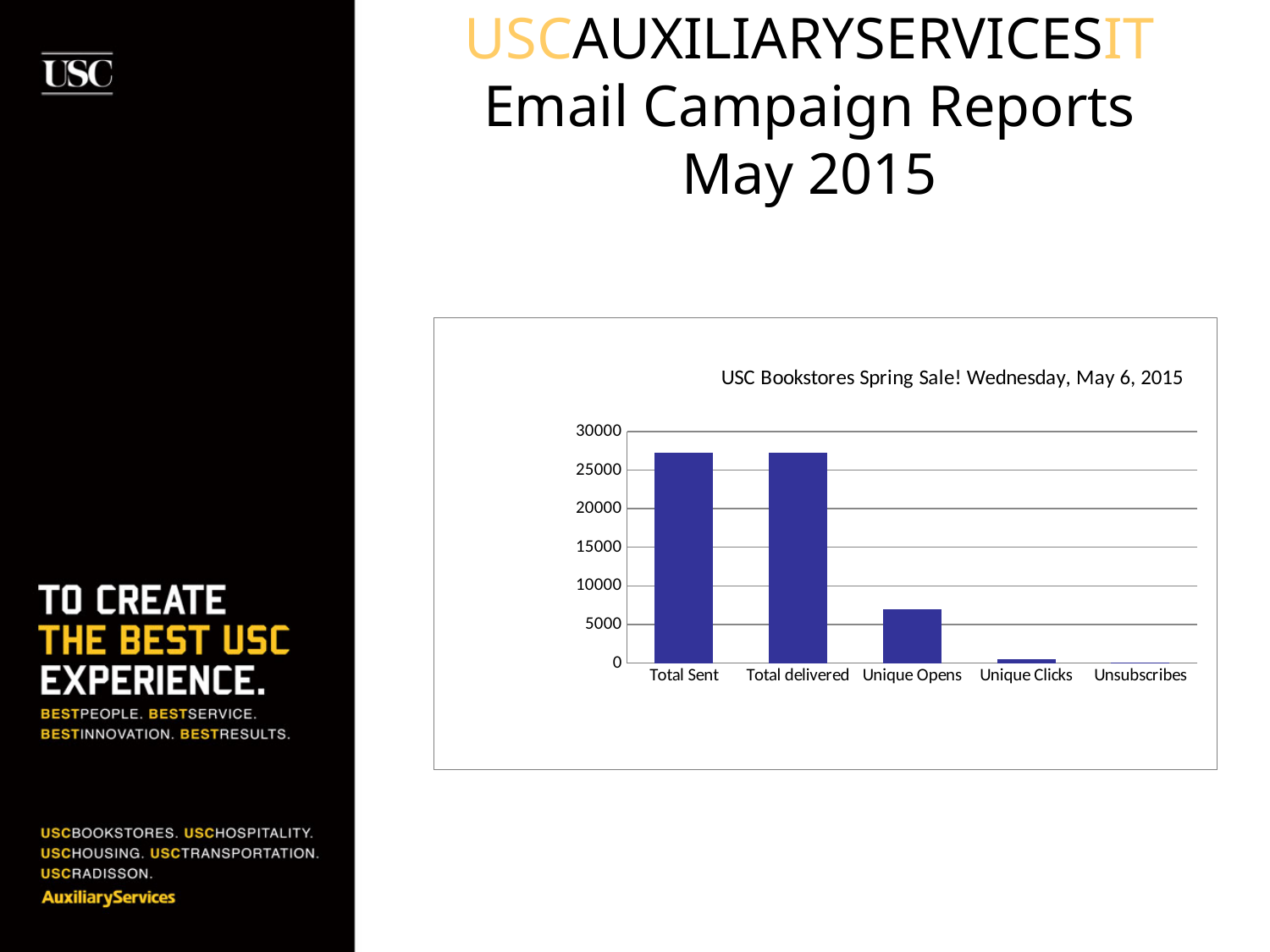
What is the highest value shown on the y axis of the chart? 30000 What is the title of the chart? USC Bookstores Spring Sale! Wednesday, May 6, 2015 Which category has the lowest value in the chart? Unsubscribes Is the value for Total Sent greater or less than 25000? greater Is the value for Unique Opens greater or less than 10000? less Which is larger, the value for Unique Opens or the value for Unique Clicks? Unique Opens Is the value for Total delivered greater or less than 25000? greater What kind of chart is shown on the slide? bar chart How many categories are shown on the x axis of the chart? 5 Do the values generally rise or fall moving from left to right along the x axis? fall